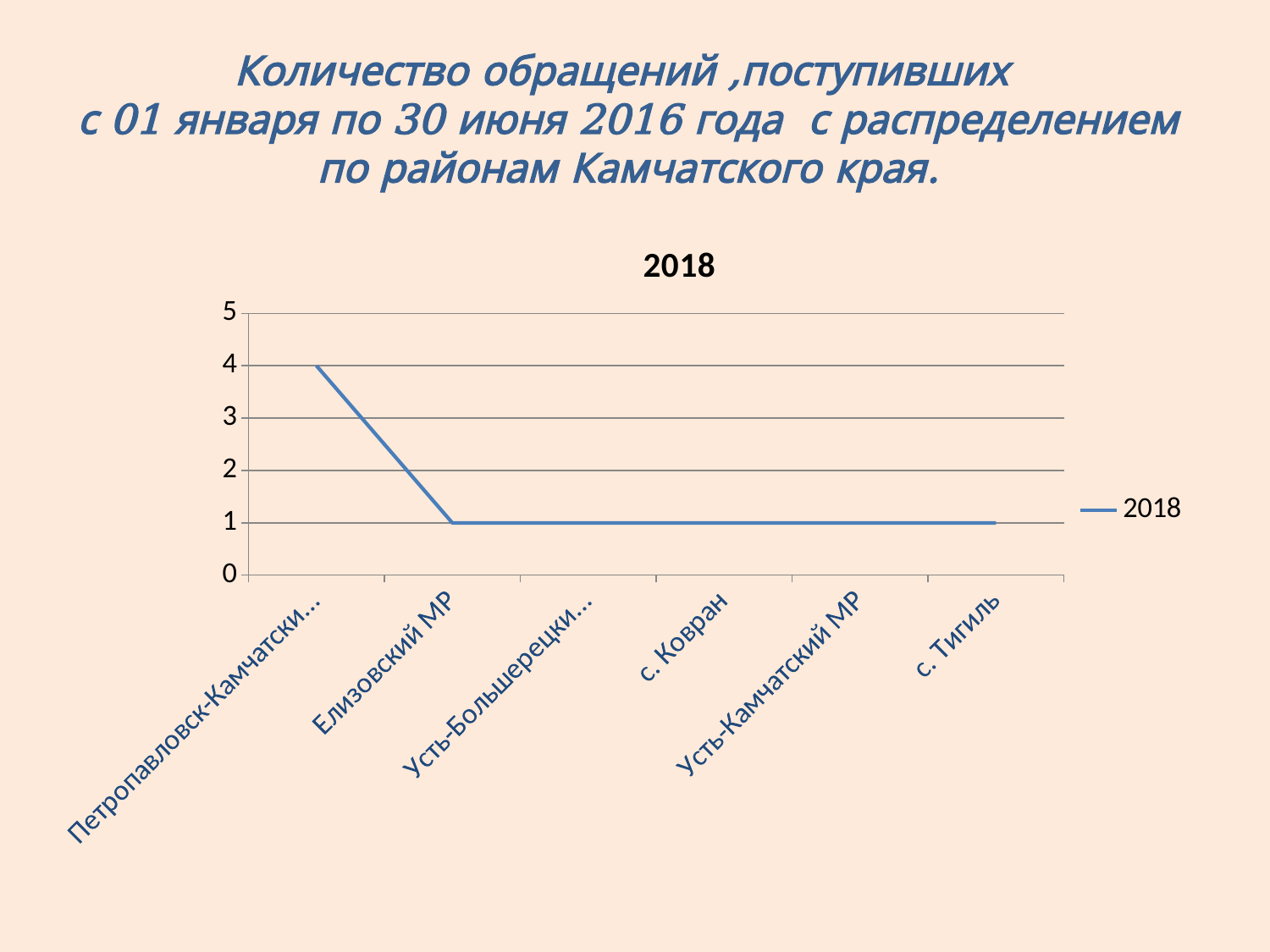
How many series does the legend list? 1 What is the title shown above the chart? 2018 How many categories are shown on the x axis? 6 Is the value for the first category (Петропавловск-Камчатский) greater or less than 3? greater Which category has the highest value? Петропавловск-Камчатский What is the value for с. Ковран? 1 What is the value for с. Тигиль? 1 Which is larger: the value for Петропавловск-Камчатский or the value for с. Ковран? Петропавловск-Камчатский What is the value for Елизовский МР? 1 What kind of chart is shown on the slide? line chart What is the difference between the value for the first category (Петропавловск-Камчатский) and the value for Елизовский МР? 3 What is the value for Усть-Камчатский МР? 1